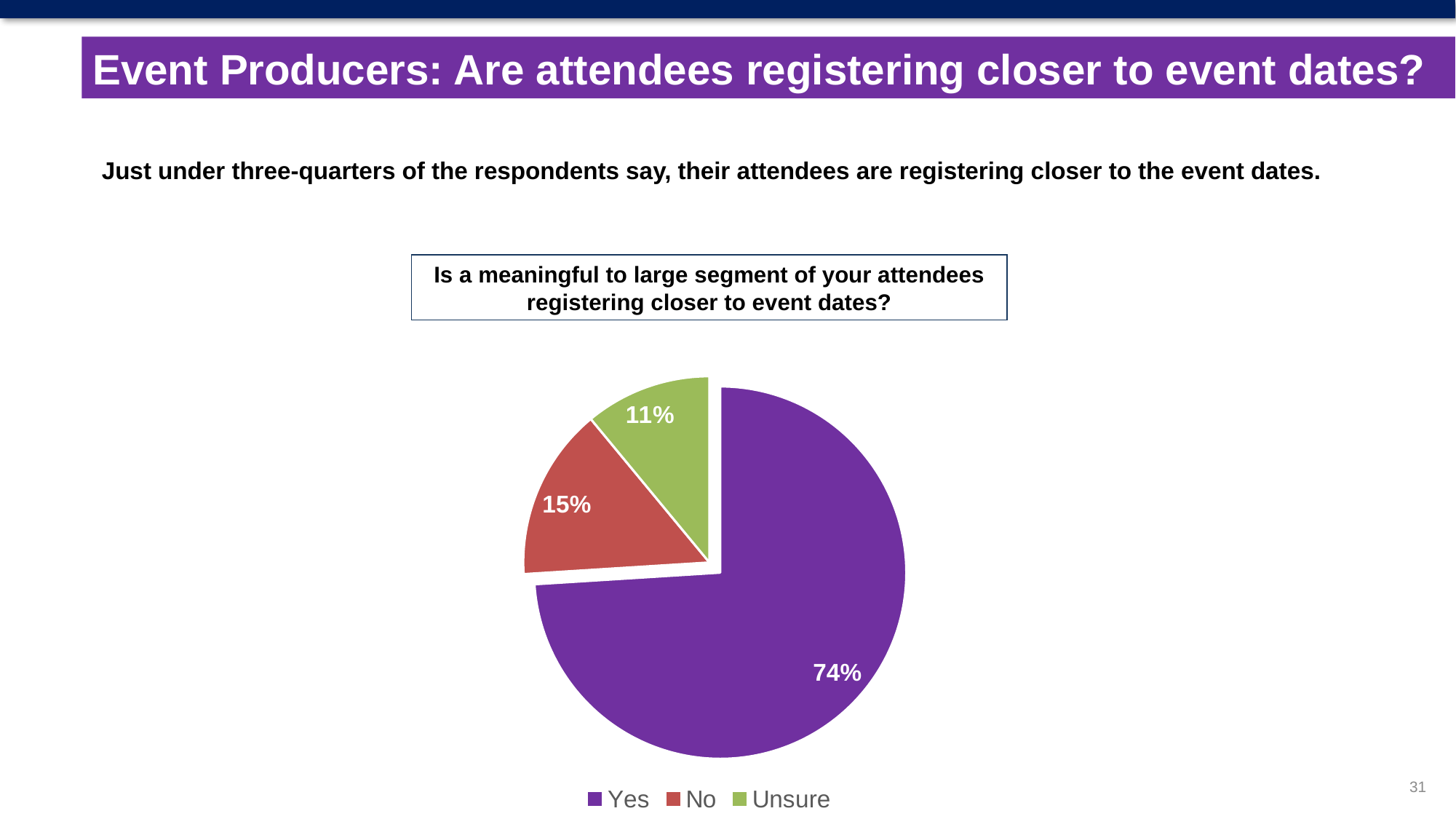
Which slice is larger, No or Unsure? No Which response has the largest share of the pie? Yes Which response has the smallest share of the pie? Unsure What is the difference in percentage points between the Yes and No slices? 59 What is the difference in percentage points between the No and Unsure slices? 4 How many slices does the pie chart have? 3 What type of chart is shown on the slide? Pie chart What percentage of respondents answered Unsure? 11% What percentage of respondents answered No? 15% What colour is the Yes slice of the pie chart? Purple What percentage of respondents answered Yes? 74% What question is shown as the title above the pie chart? Is a meaningful to large segment of your attendees registering closer to event dates?